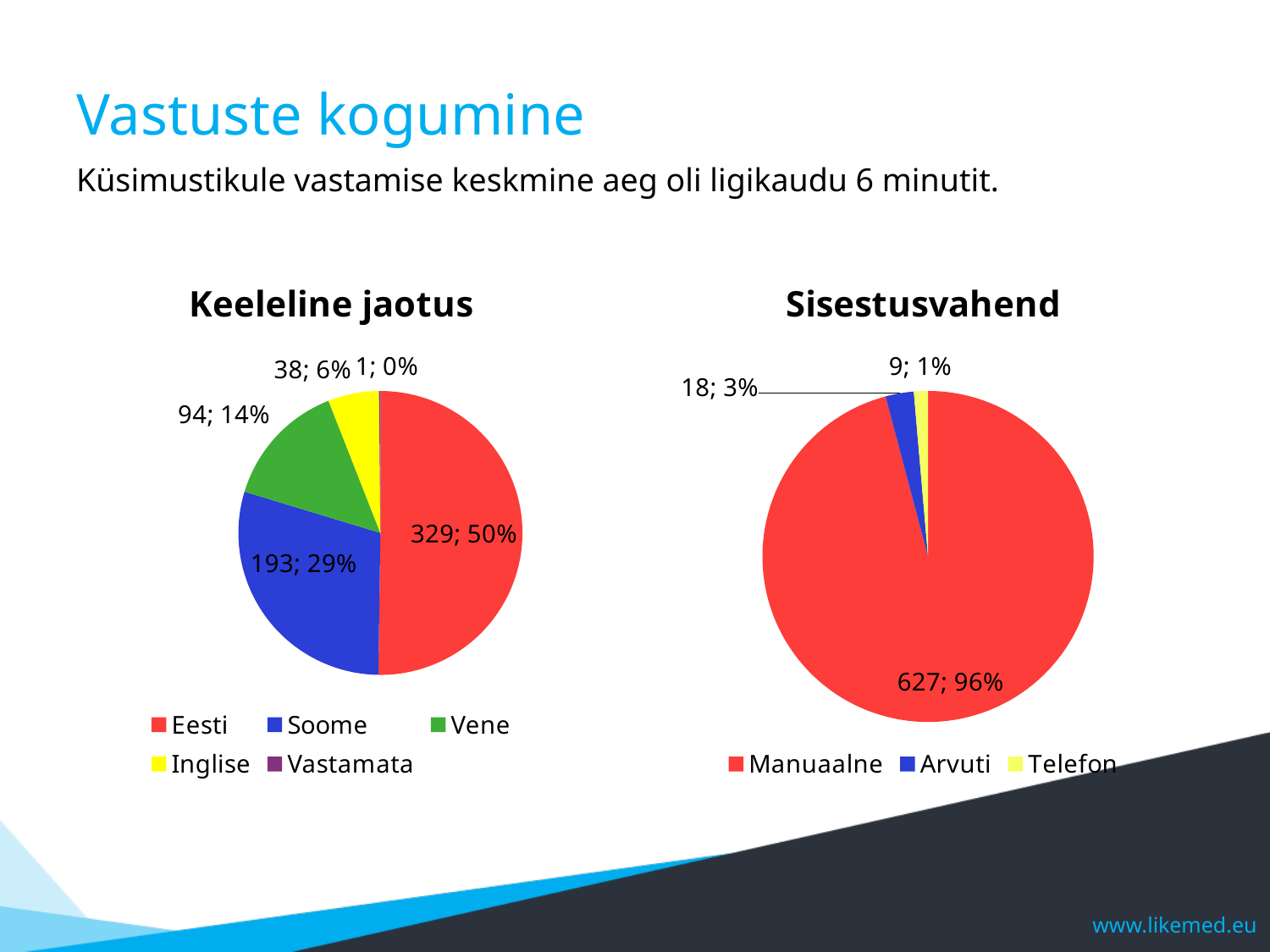
In the 'Keeleline jaotus' chart, what is the count shown for Vene? 94 In the 'Sisestusvahend' chart, which category has the largest slice? Manuaalne In the 'Keeleline jaotus' chart, what colour is the Inglise slice? Yellow In the 'Keeleline jaotus' chart, what share of the pie does Soome have? 29% In the 'Sisestusvahend' chart, what is the count shown for Manuaalne? 627 In the 'Sisestusvahend' chart, which is larger, Arvuti or Telefon? Arvuti In the 'Keeleline jaotus' chart, what is the count shown for Eesti? 329 In the 'Keeleline jaotus' chart, how many categories does the legend list? 5 In the 'Sisestusvahend' chart, what share of the pie does Arvuti have? 3% In the 'Keeleline jaotus' chart, which category has the smallest slice? Vastamata In the 'Keeleline jaotus' chart, what is the difference between the counts for Eesti and Soome? 136 What kind of chart is the 'Sisestusvahend' chart? Pie chart